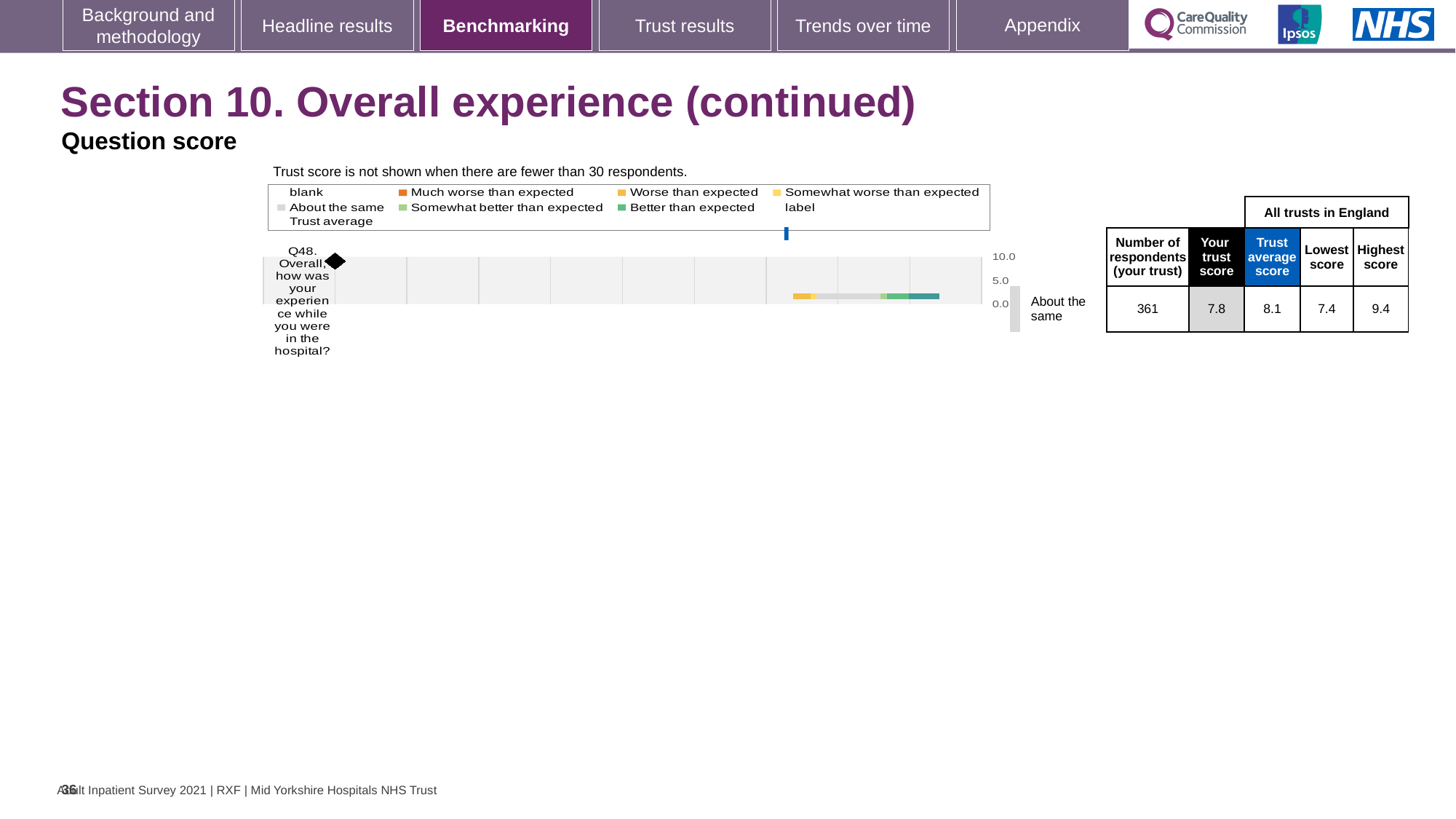
How many questions are plotted on the chart? 1 What is the 'Your trust score' for Q48 (Overall, how was your experience while you were in the hospital?)? 7.8 By how much does the trust average score exceed your trust score for Q48? 0.3 Which is larger for Q48: your trust score or the trust average score? Trust average score What is the highest score among all trusts in England for Q48? 9.4 What is the lowest score among all trusts in England for Q48? 7.4 How many respondents from your trust answered Q48? 361 What is the difference between the highest score and the lowest score for Q48? 2.0 How is your trust's result for Q48 categorised relative to other trusts? About the same What is the trust average score across all trusts in England for Q48? 8.1 What kind of chart is used to show the Q48 benchmarking result? Bar chart Below how many respondents is the trust score not shown? 30